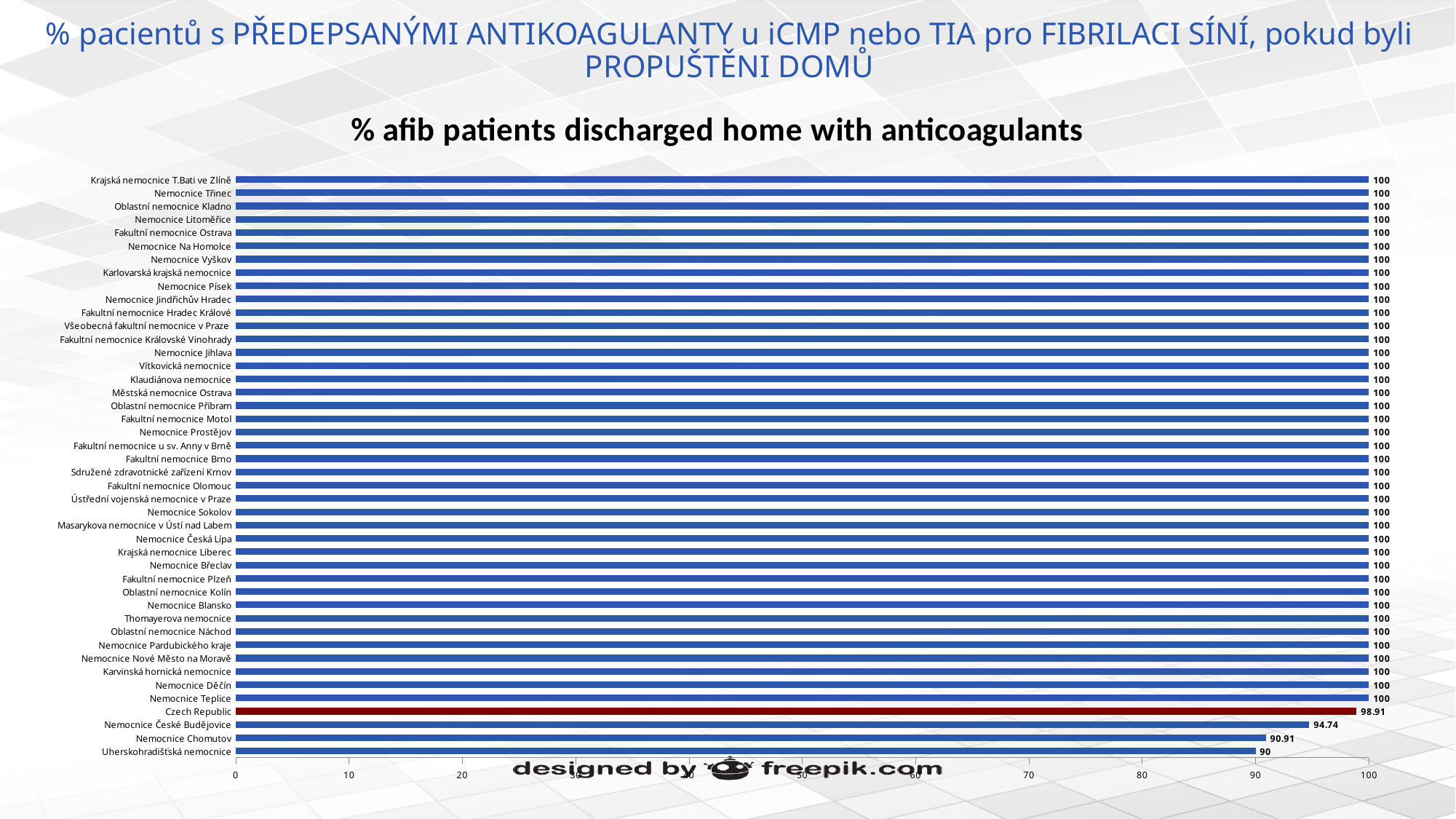
What is the title of the chart? % afib patients discharged home with anticoagulants What is the value for Uherskohradišťská nemocnice? 90 What is the difference between the values for Nemocnice České Budějovice and Nemocnice Chomutov? 3.83 What is the value for Fakultní nemocnice Motol? 100 What is the value for Nemocnice České Budějovice? 94.74 What kind of chart is shown on the slide? bar chart What is the value for Nemocnice Chomutov? 90.91 What is the value for Czech Republic? 98.91 What is the difference between the values for Czech Republic and Uherskohradišťská nemocnice? 8.91 Which is larger, the value for Nemocnice Chomutov or the value for Nemocnice České Budějovice? Nemocnice České Budějovice Which bar is shown in a different colour (red) from the others? Czech Republic Which category has the lowest value? Uherskohradišťská nemocnice